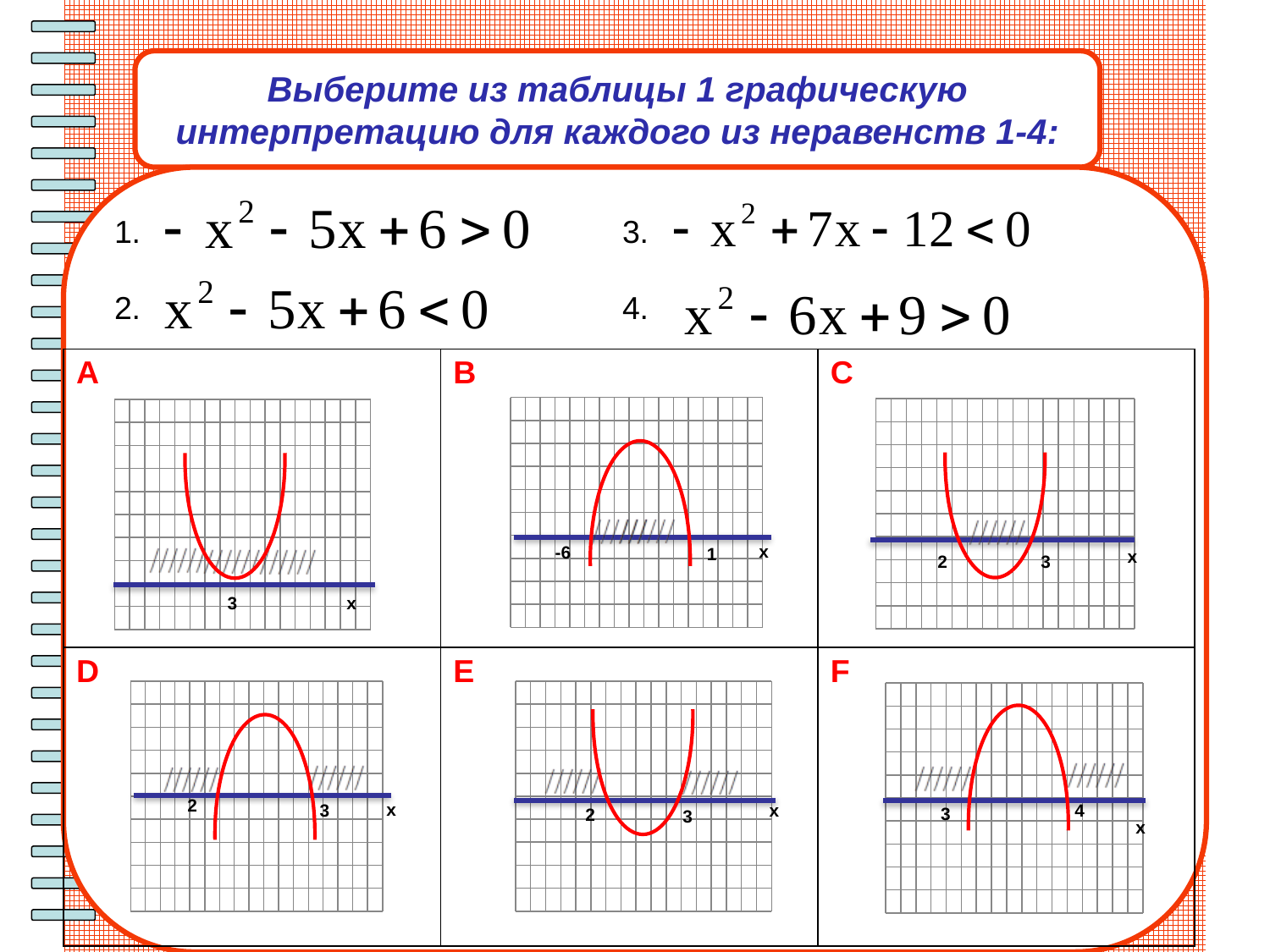
Which graph has the x-axis mark -6? B In graph F, which marked x value is larger, 3 or 4? 4 In graph B, what two values are marked on the x axis? -6 and 1 How many graphs are shown in the table on the slide? 6 In graph B, does the parabola open upward or downward? downward In graph E, does the parabola open upward or downward? upward In graph F, what two values are marked on the x axis? 3 and 4 In graph C, what two values are marked on the x axis? 2 and 3 Which graph shows a parabola that touches the x axis at only one point? A In graph D, what two values are marked on the x axis? 2 and 3 What letters label the six graphs on the slide? A, B, C, D, E, F In graph A, what value is marked on the x axis where the parabola touches it? 3